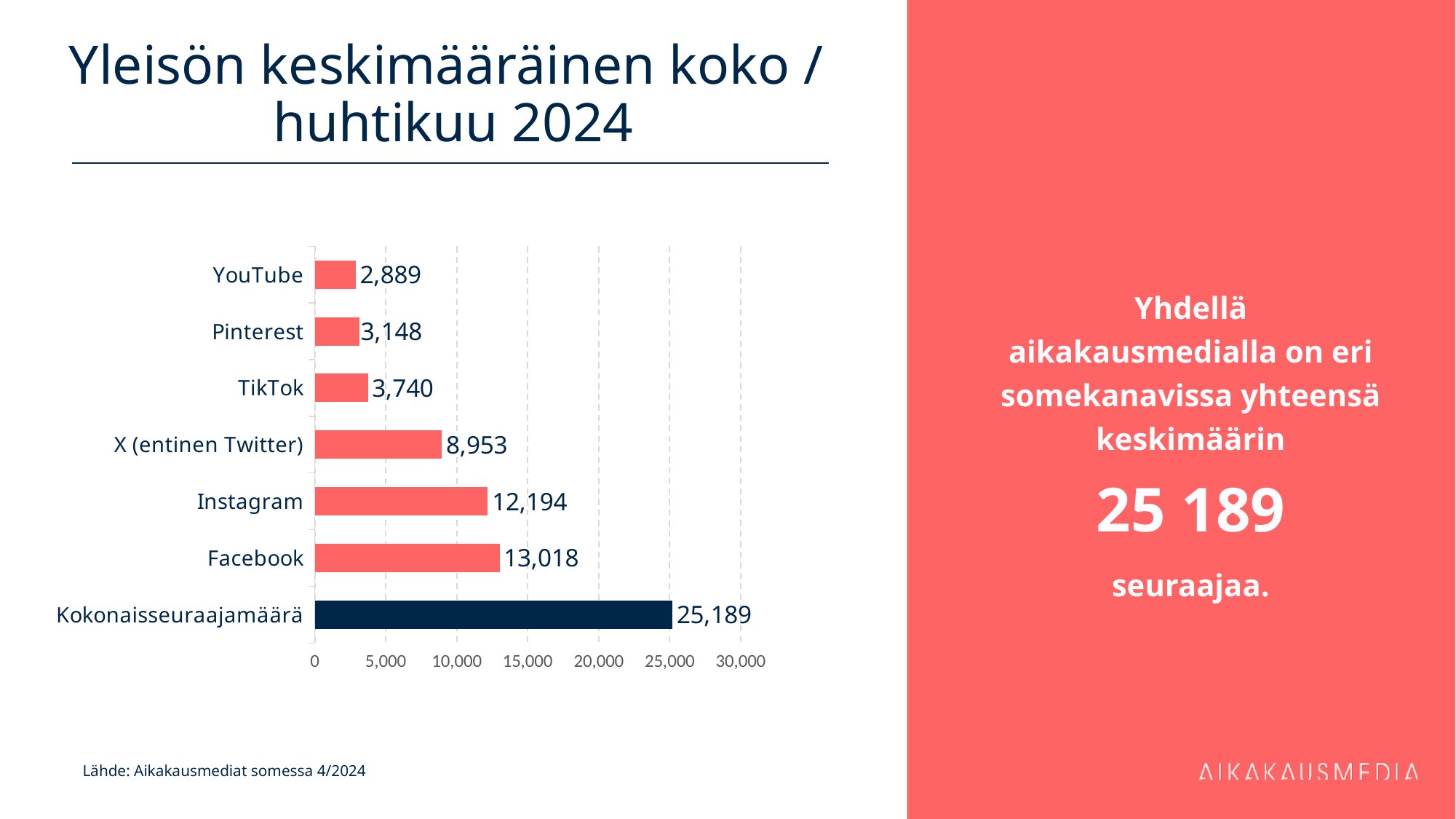
Which category has the highest value? Kokonaisseuraajamäärä What is the value for YouTube? 2,889 How many categories are shown in the chart? 7 What is the difference between the values for Facebook and Instagram? 824 What is the value for X (entinen Twitter)? 8,953 Is the value for Instagram greater or less than 10,000? greater Which bar is coloured dark navy instead of red? Kokonaisseuraajamäärä What kind of chart is shown on the slide? bar chart What is the title of the slide? Yleisön keskimääräinen koko / huhtikuu 2024 Which is larger, the value for TikTok or the value for Pinterest? TikTok Which category has the lowest value? YouTube What is the value for Facebook? 13,018